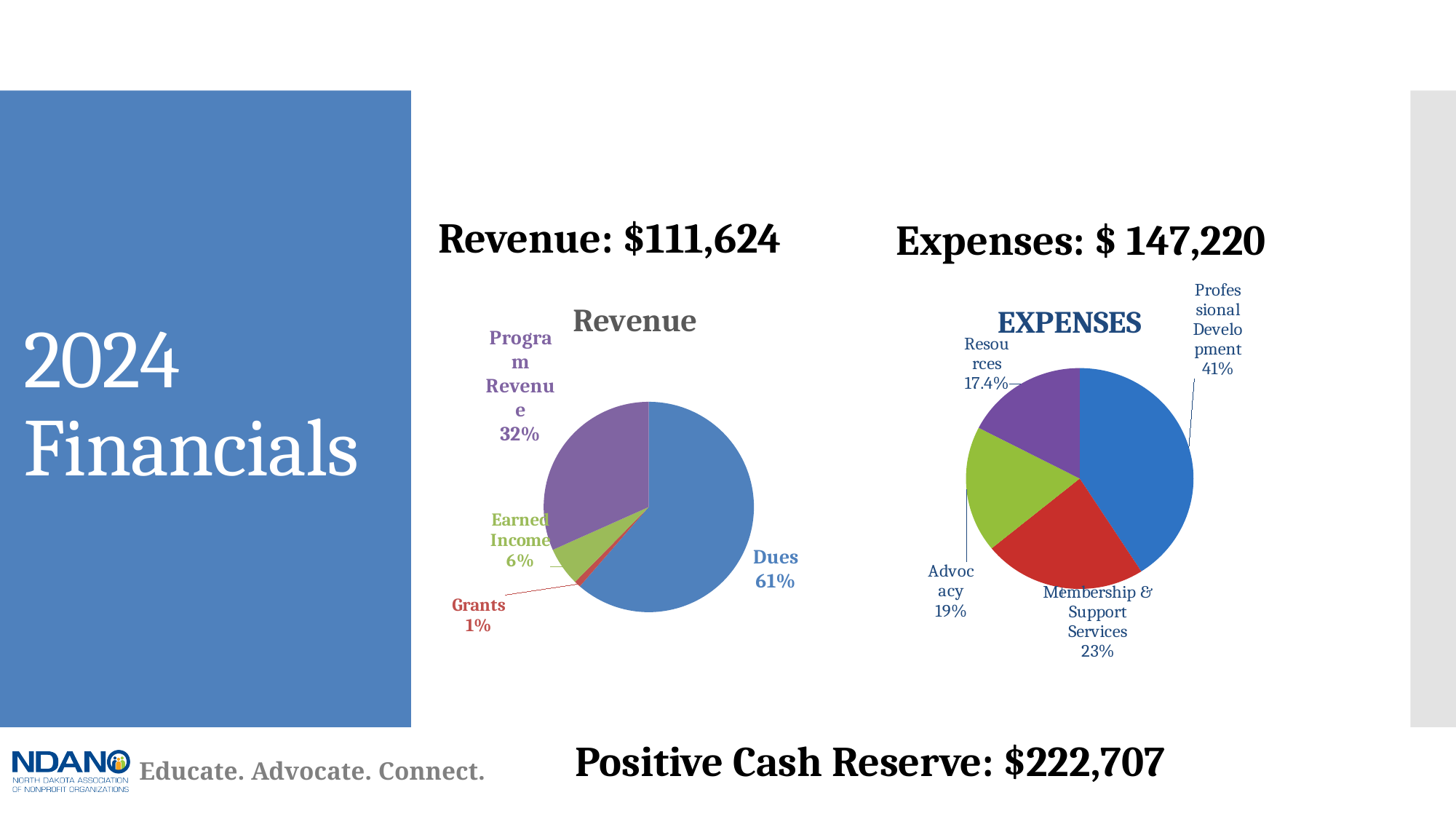
In the Revenue pie chart, what percentage is Program Revenue? 32% In the Revenue pie chart, which category has the smallest share? Grants In the EXPENSES pie chart, which is larger, Membership & Support Services or Advocacy? Membership & Support Services In the EXPENSES pie chart, what percentage is Resources? 17.4% In the Revenue pie chart, what share of revenue comes from Dues? 61% In the EXPENSES pie chart, which category has the smallest share? Resources In the EXPENSES pie chart, what percentage is Professional Development? 41% In the Revenue pie chart, which category has the largest share? Dues How many slices does the Revenue pie chart have? 4 How many categories are shown in the EXPENSES pie chart? 4 What type of chart is the EXPENSES chart? Pie chart In the Revenue pie chart, what is the difference in percentage points between Dues and Program Revenue? 29